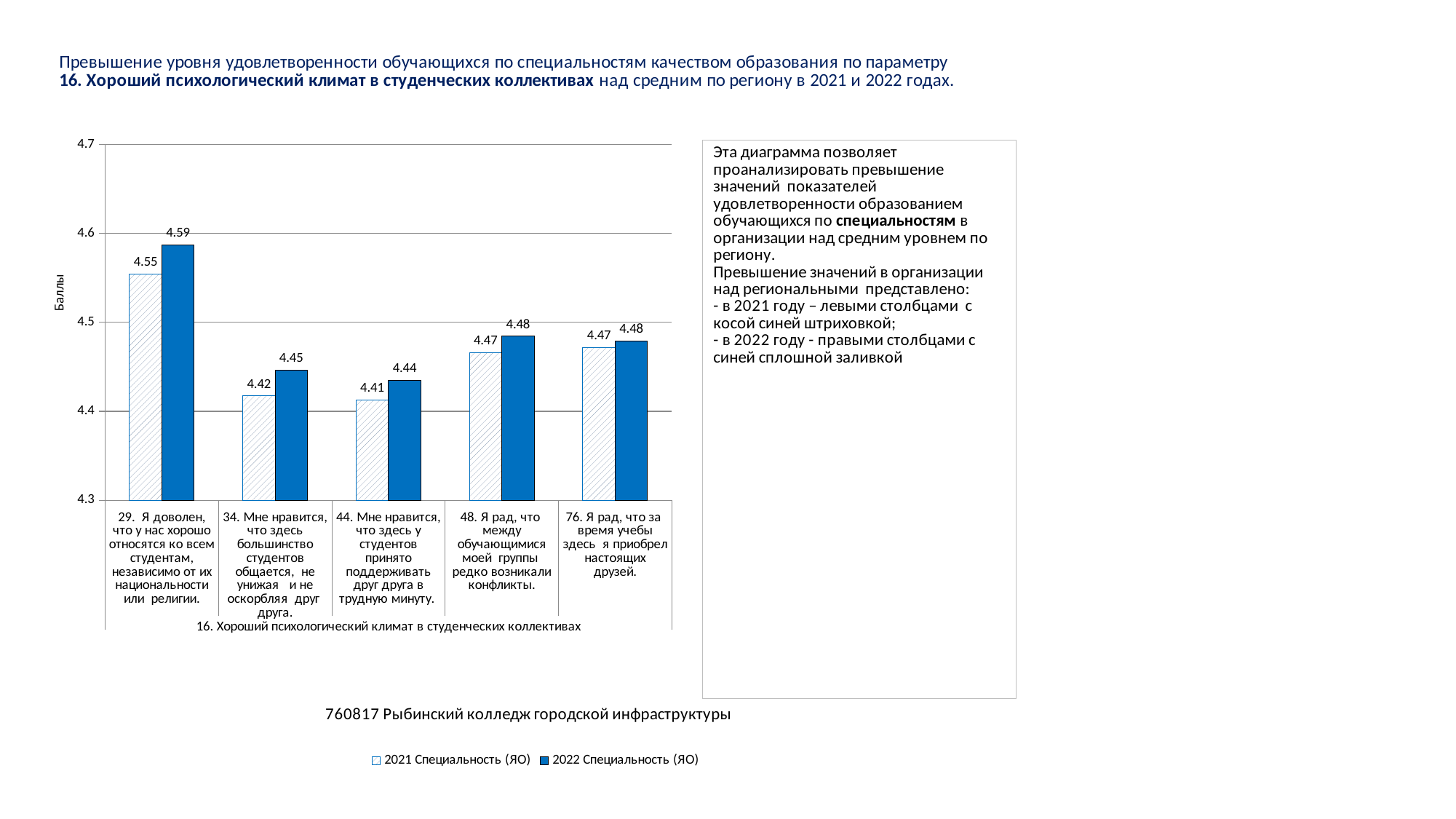
What is the 2022 Специальность (ЯО) value for item 29 (Я доволен, что у нас хорошо относятся ко всем студентам)? 4.59 Is the 2021 value for item 29 greater or less than 4.5? greater What is the 2021 Специальность (ЯО) value for item 44 (Мне нравится, что здесь у студентов принято поддерживать друг друга)? 4.41 What is the 2021 Специальность (ЯО) value for item 76 (Я рад, что за время учебы здесь я приобрел настоящих друзей)? 4.47 Which item has the highest 2022 Специальность (ЯО) value? 29. Я доволен, что у нас хорошо относятся ко всем студентам, независимо от их национальности или религии. How many items (categories) are shown on the x axis of the chart? 5 What is the difference between the 2022 and 2021 values for item 29? 0.04 What type of chart is shown on the slide? bar chart How many series does the legend list? 2 Which item has the lowest 2021 Специальность (ЯО) value? 44. Мне нравится, что здесь у студентов принято поддерживать друг друга в трудную минуту. What is the difference between the 2022 values for item 29 and item 44? 0.15 For item 34, which is larger: the 2021 value or the 2022 value? 2022 value